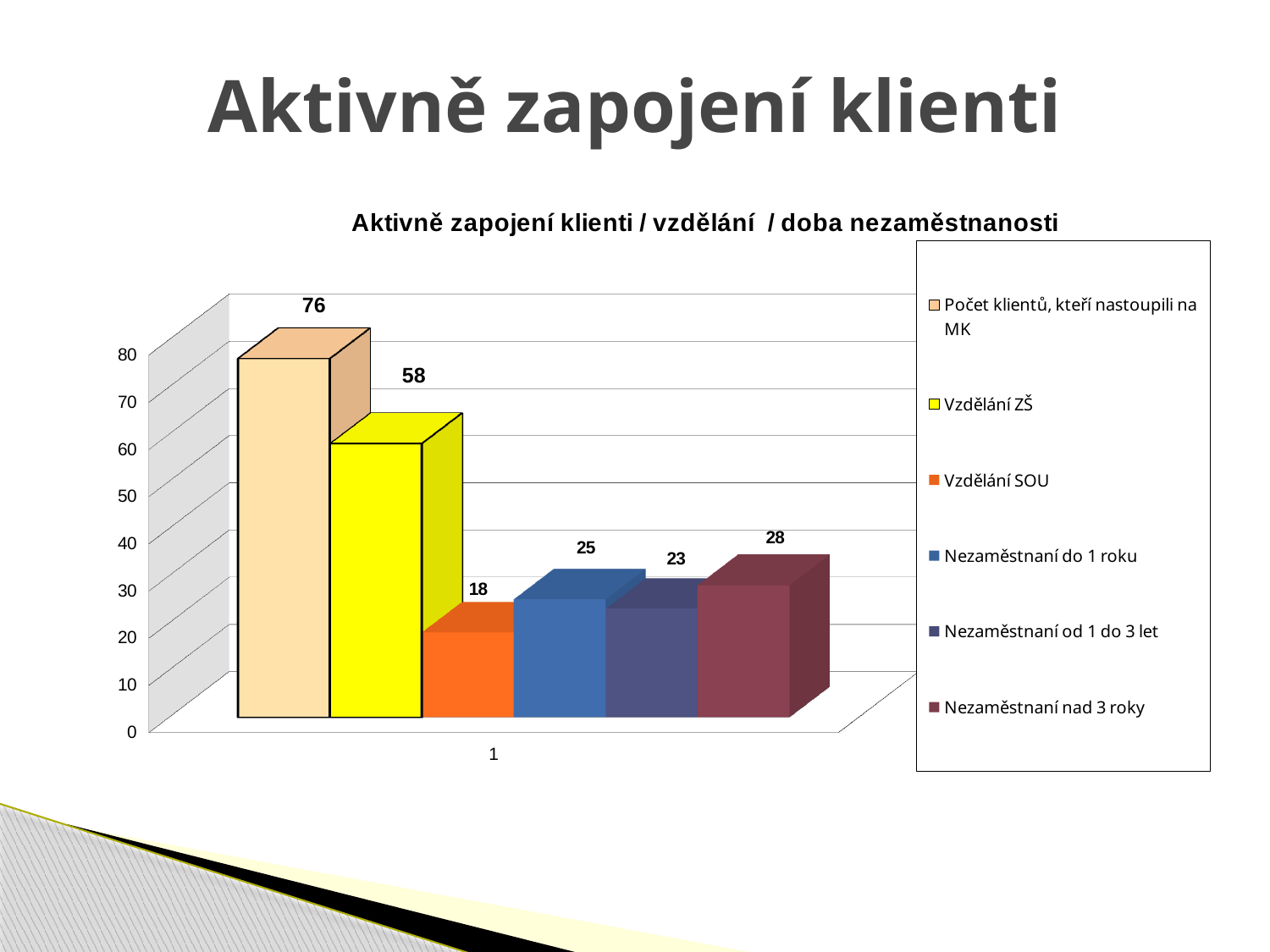
Which series has the highest value? Počet klientů, kteří nastoupili na MK What is the difference between 'Nezaměstnaní nad 3 roky' and 'Nezaměstnaní od 1 do 3 let'? 5 What is the difference between 'Vzdělání ZŠ' and 'Vzdělání SOU'? 40 What is the title of the chart? Aktivně zapojení klienti / vzdělání / doba nezaměstnanosti What kind of chart is shown? bar chart Which is larger, 'Nezaměstnaní do 1 roku' or 'Nezaměstnaní od 1 do 3 let'? Nezaměstnaní do 1 roku What is the value for 'Nezaměstnaní nad 3 roky'? 28 What is the value for 'Vzdělání SOU'? 18 Which series has the lowest value? Vzdělání SOU What is the value for 'Počet klientů, kteří nastoupili na MK'? 76 What is the value for 'Vzdělání ZŠ'? 58 How many series does the legend list? 6